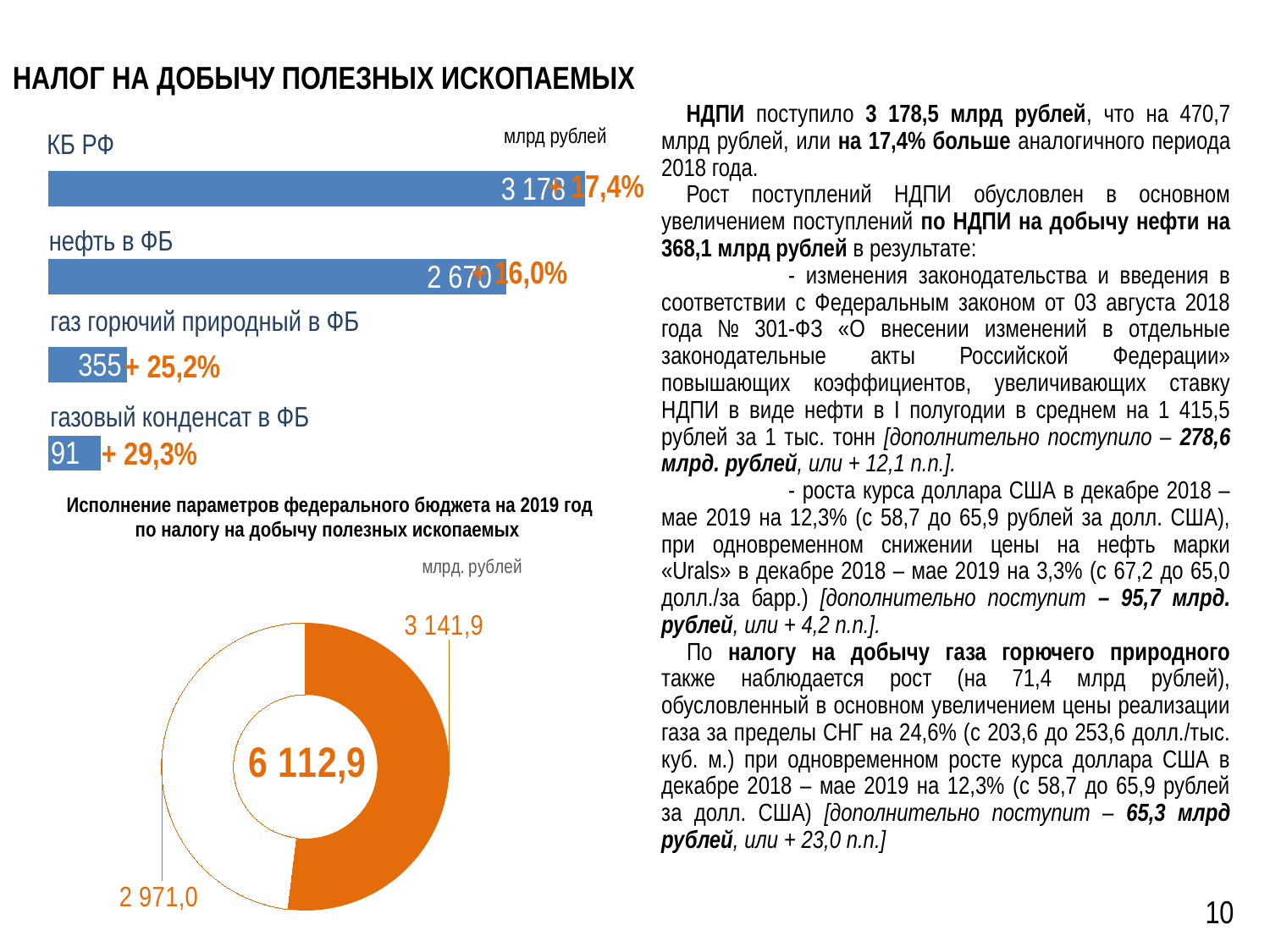
In the bottom-left donut chart, what total value is shown in the centre? 6 112,9 In the top-left bar chart, what is the difference between the values for газ горючий природный в ФБ and газовый конденсат в ФБ? 264 In the bottom-left donut chart, which of the two slices is larger, 3 141,9 or 2 971,0? 3 141,9 In the top-left bar chart, how many categories are shown? 4 In the top-left bar chart, what is the value for газ горючий природный в ФБ? 355 In the top-left bar chart, which category has the longest bar? КБ РФ In the top-left bar chart, what growth percentage is shown next to газ горючий природный в ФБ? + 25,2% What kind of chart is the bottom-left chart on the slide? donut (pie) chart In the top-left bar chart, which category has the shortest bar? газовый конденсат в ФБ In the top-left bar chart, what growth percentage is shown next to газовый конденсат в ФБ? + 29,3% In the top-left bar chart, what is the value for газовый конденсат в ФБ? 91 What kind of chart is the top-left chart on the slide? bar chart